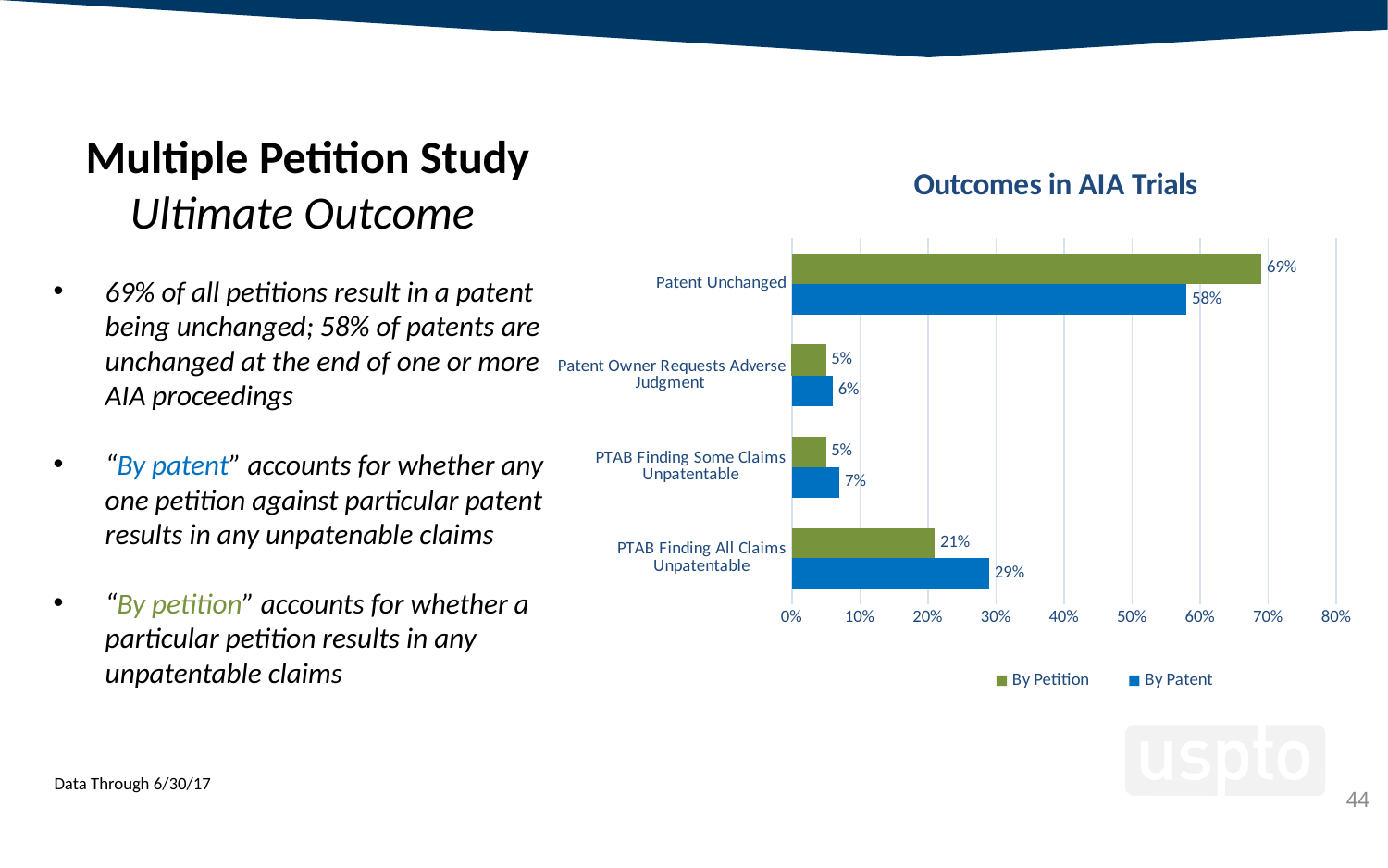
For PTAB Finding All Claims Unpatentable, which is larger: the By Petition value or the By Patent value? By Patent What is the difference between the By Patent and By Petition values for PTAB Finding All Claims Unpatentable? 8% What is the By Petition value for Patent Unchanged? 69% What type of chart is shown on the slide? Bar chart What is the By Patent value for PTAB Finding Some Claims Unpatentable? 7% What is the By Patent value for PTAB Finding All Claims Unpatentable? 29% Which category has the highest By Patent value? Patent Unchanged How many categories are shown on the chart? 4 How many series does the legend list? 2 Which category has the lowest By Patent value? Patent Owner Requests Adverse Judgment What is the By Petition value for Patent Owner Requests Adverse Judgment? 5% What is the difference between the By Petition and By Patent values for Patent Unchanged? 11%